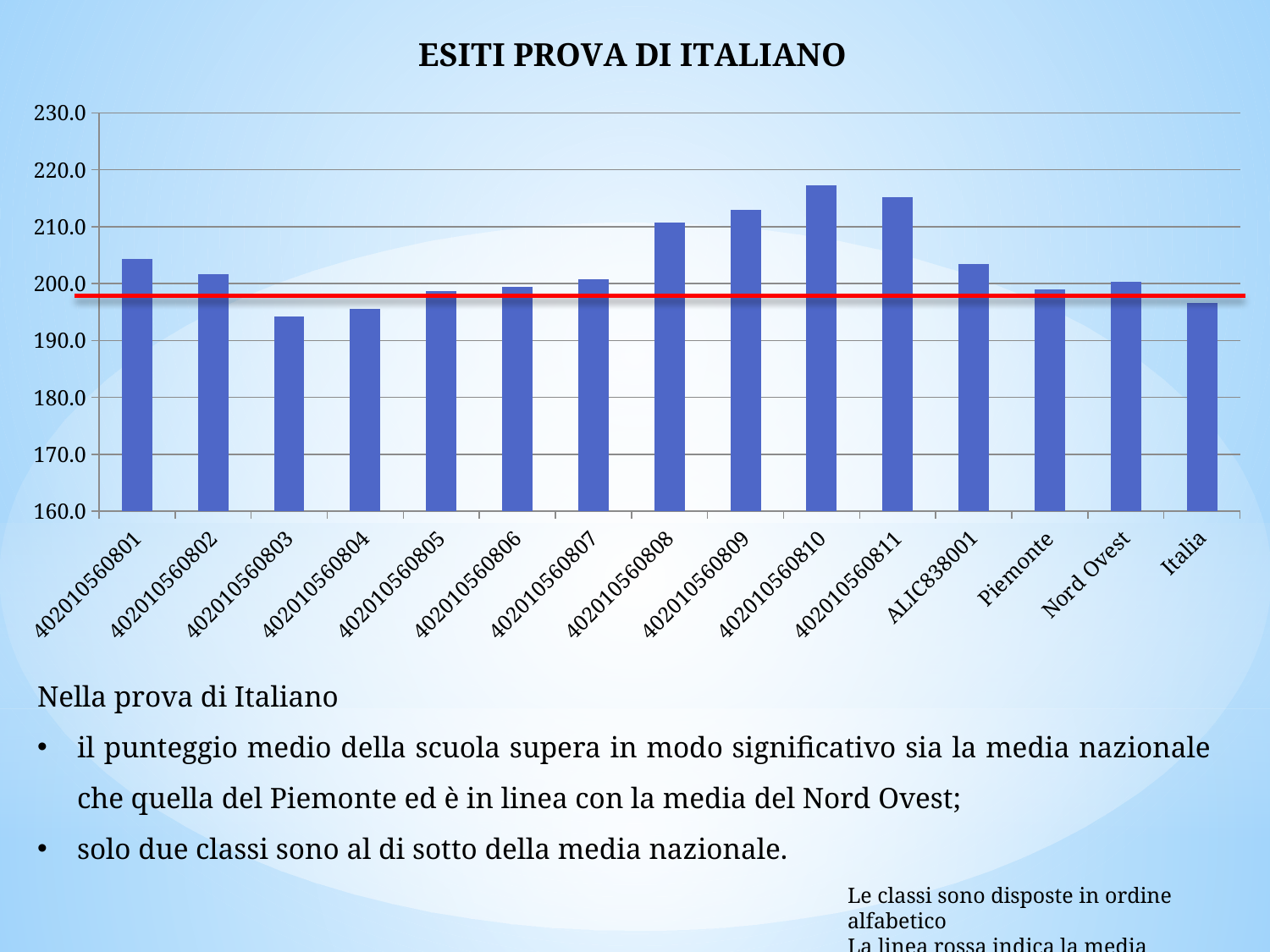
Is the value for 402010560810 greater or less than 210.0? greater Which category has the highest bar in the chart? 402010560810 Is the value for 402010560809 greater or less than 210.0? greater What is the title of the chart? ESITI PROVA DI ITALIANO How many categories are shown on the x axis of the chart? 15 Which category has the lowest bar in the chart? 402010560803 Is the value for 402010560803 greater or less than 200.0? less Which is larger, the value for ALIC838001 or the value for Italia? ALIC838001 Which is larger, the value for 402010560808 or the value for 402010560804? 402010560808 What colour are the bars in the chart? blue What kind of chart is shown on the slide? bar chart